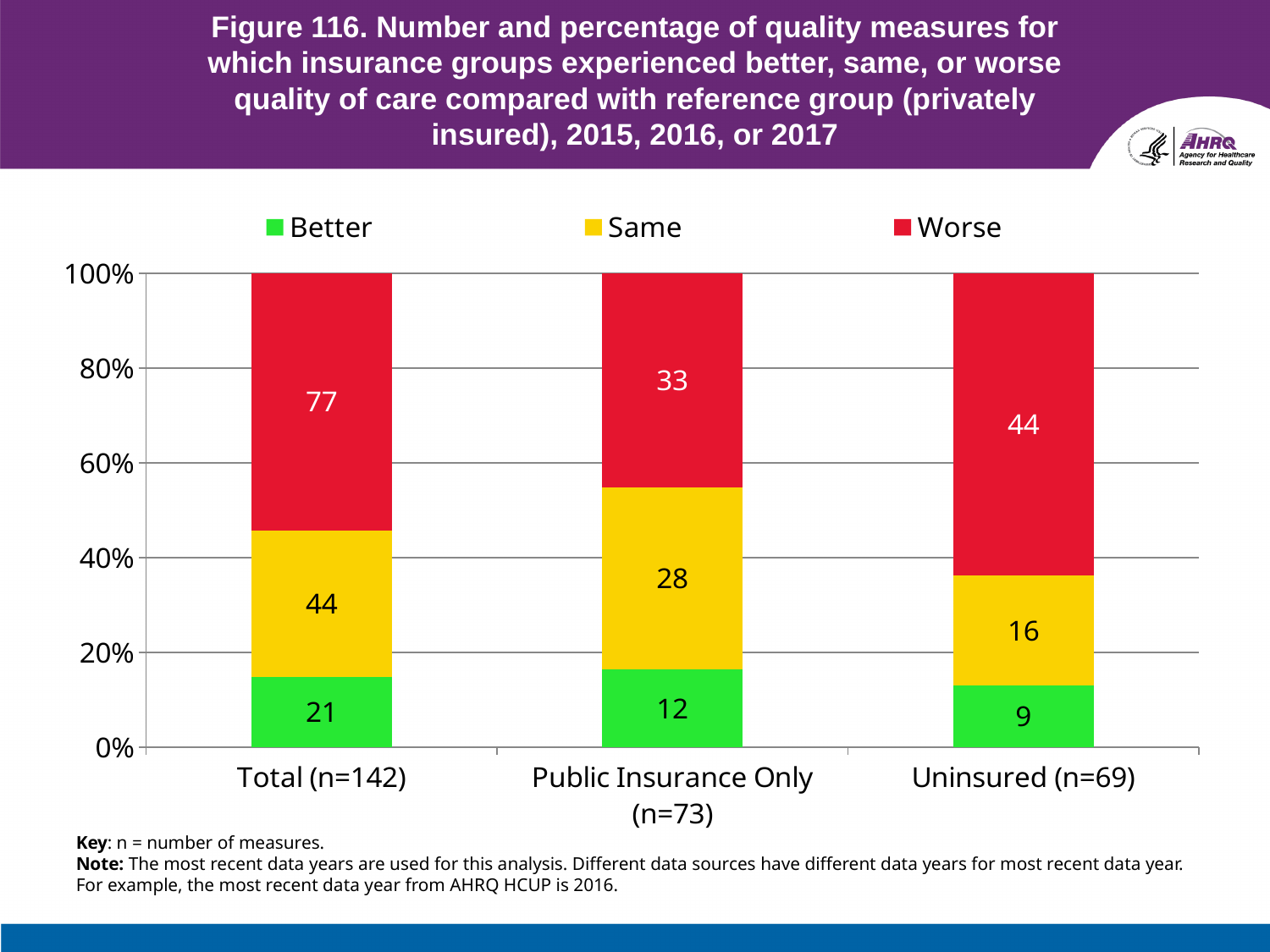
What is the total number of measures in the Public Insurance Only bar (Better + Same + Worse)? 73 What kind of chart is shown on the slide? Stacked bar chart Which insurance group has the highest number of Worse measures? Total (n=142) Is the Better segment for Total (n=142) greater or less than 20% of the bar? less What is the difference between the Worse and Better counts for Uninsured (n=69)? 35 What is the number of measures labelled Worse for the Total (n=142) group? 77 Which is larger for Public Insurance Only (n=73): the Same count or the Worse count? Worse How many series does the legend list? 3 How many insurance groups are shown on the x axis? 3 What is the number of measures labelled Better for Uninsured (n=69)? 9 Which insurance group has the lowest number of Better measures? Uninsured (n=69) What is the number of measures labelled Same for Public Insurance Only (n=73)? 28